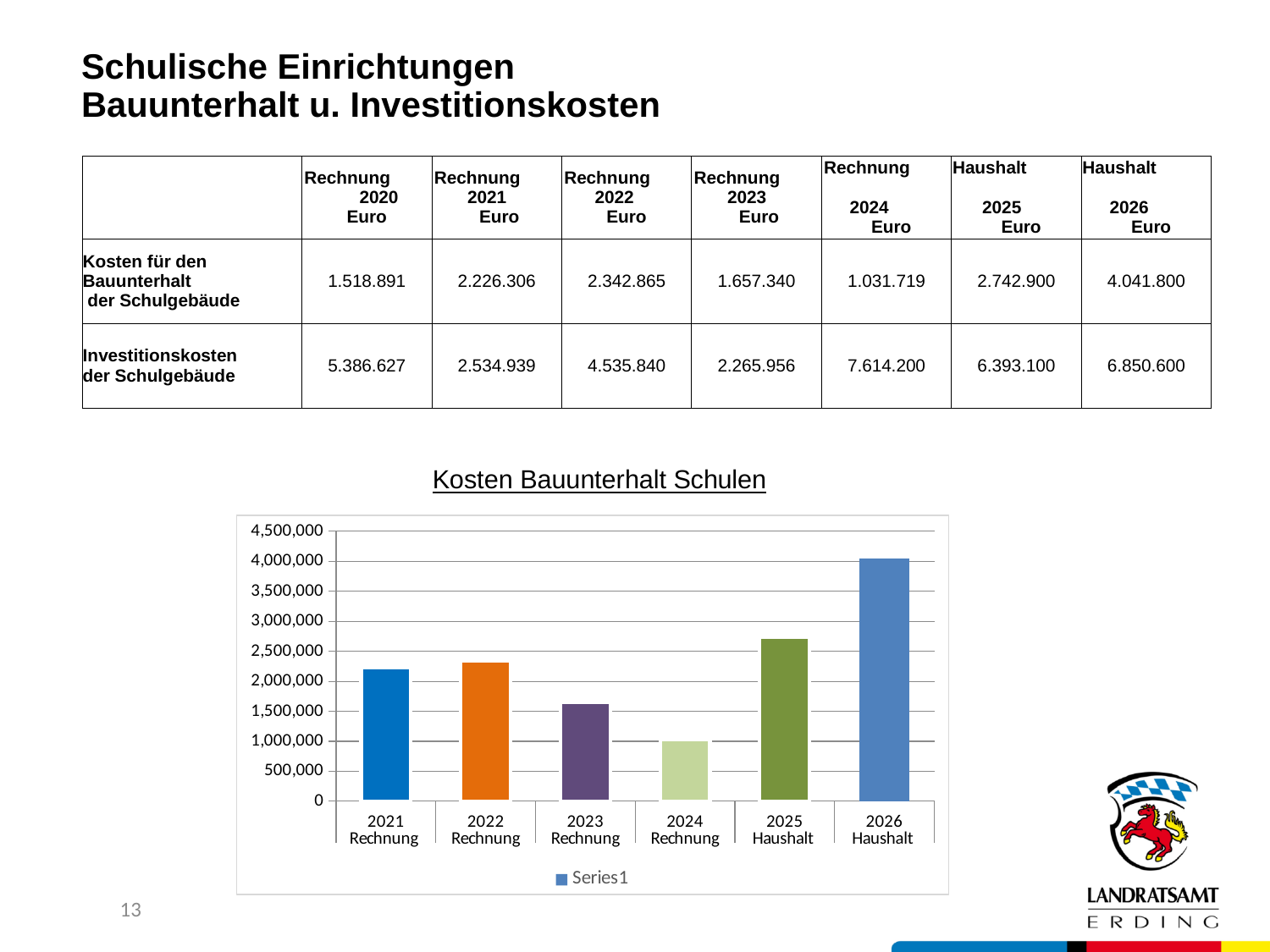
According to the table, what are the Kosten für den Bauunterhalt der Schulgebäude for Rechnung 2024? 1.031.719 In the "Kosten Bauunterhalt Schulen" chart, is the value for 2025 Haushalt greater or less than 2,500,000? greater What is the name of the series in the legend of the "Kosten Bauunterhalt Schulen" chart? Series1 What kind of chart is "Kosten Bauunterhalt Schulen"? bar chart According to the table, what are the Kosten für den Bauunterhalt der Schulgebäude for Haushalt 2026? 4.041.800 In the "Kosten Bauunterhalt Schulen" chart, is the value for 2021 Rechnung greater or less than 2,000,000? greater In the "Kosten Bauunterhalt Schulen" chart, which bar is taller: 2023 Rechnung or 2025 Haushalt? 2025 Haushalt How many series does the legend of the "Kosten Bauunterhalt Schulen" chart list? 1 Which category has the lowest bar in the "Kosten Bauunterhalt Schulen" chart? 2024 Rechnung Which category has the highest bar in the "Kosten Bauunterhalt Schulen" chart? 2026 Haushalt In the "Kosten Bauunterhalt Schulen" chart, is the value for 2024 Rechnung greater or less than 1,500,000? less How many bars are shown in the "Kosten Bauunterhalt Schulen" chart? 6